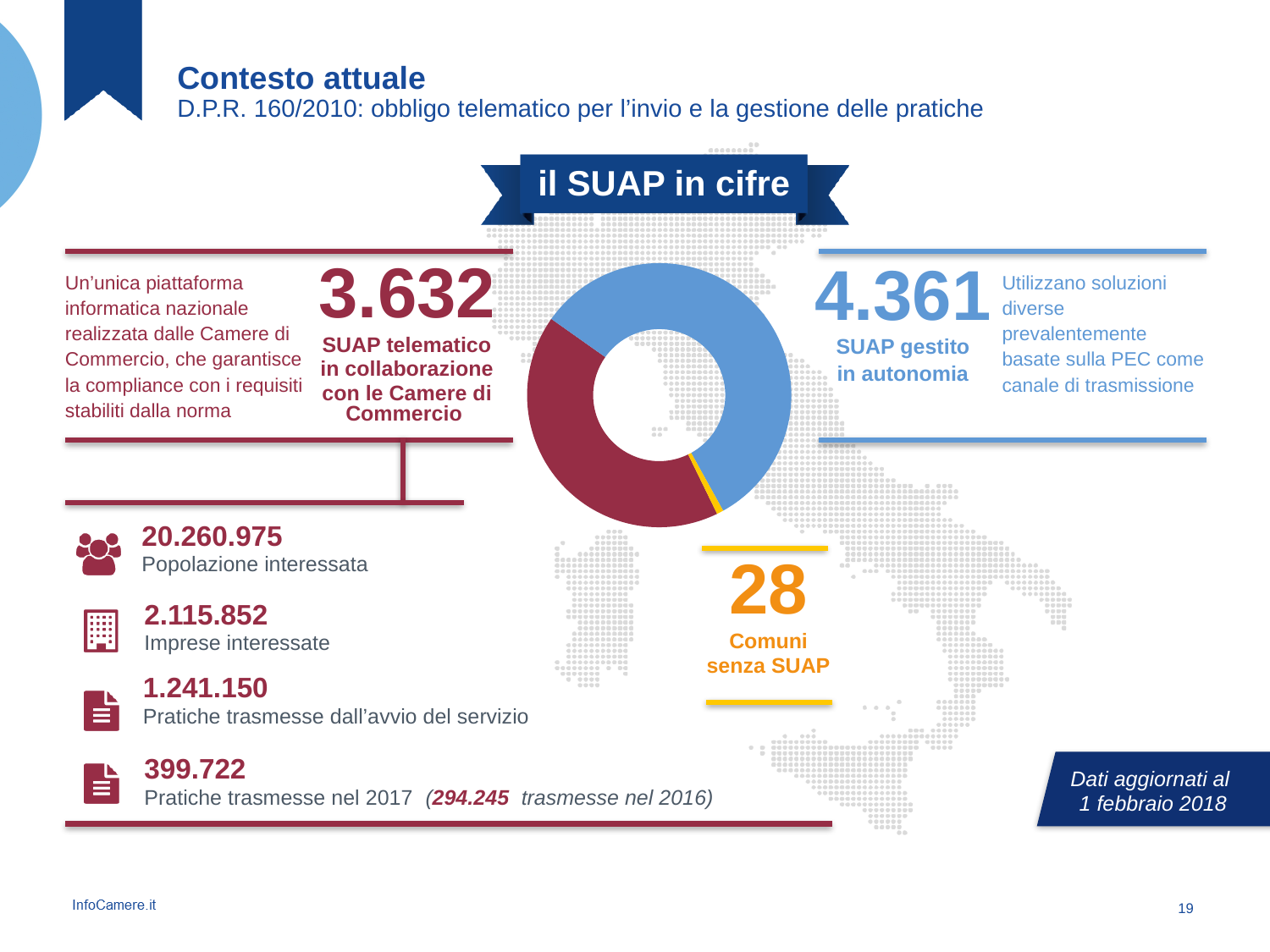
What kind of chart is shown in the centre of the slide? Donut chart How many SUAP telematico are run in collaboration with the Camere di Commercio? 3.632 Which category has the smallest slice of the donut chart? Comuni senza SUAP What is the title shown in the banner above the donut chart? il SUAP in cifre What is the difference between the number of SUAP gestito in autonomia and the number of SUAP telematico in collaborazione con le Camere di Commercio? 729 How many slices does the donut chart have? 3 Which is larger: SUAP gestito in autonomia or SUAP telematico in collaborazione con le Camere di Commercio? SUAP gestito in autonomia How many Comuni are without a SUAP (Comuni senza SUAP)? 28 Which colour represents the Comuni senza SUAP in the donut chart? Yellow How many SUAP are managed in autonomy (SUAP gestito in autonomia)? 4.361 Which category has the largest slice of the donut chart? SUAP gestito in autonomia What is the total of the three values represented in the donut chart? 8.021